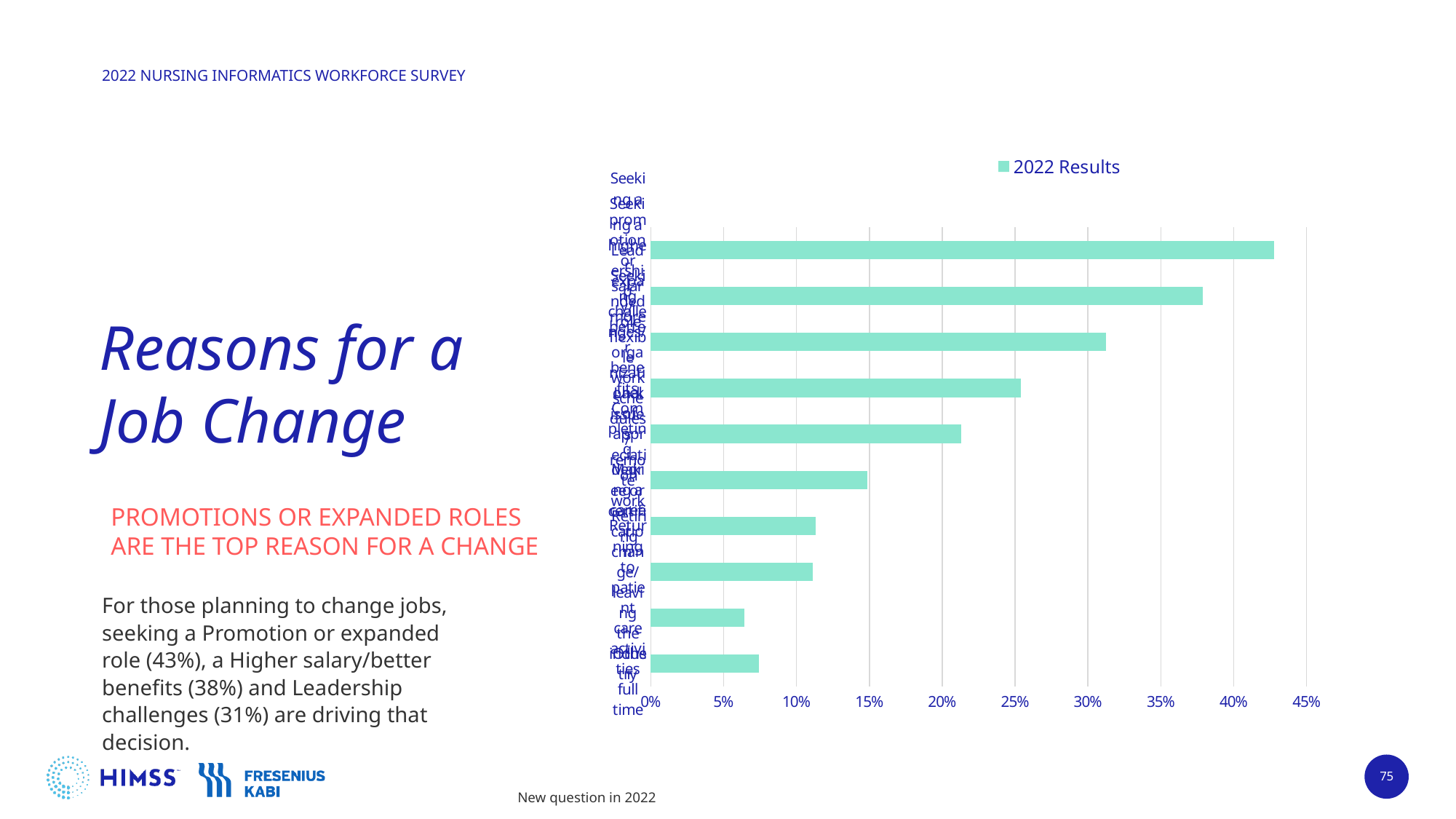
Is the value of the top bar in the chart greater or less than 40%? greater What kind of chart is shown on the slide? bar chart Which bar is the longest in the chart: the top bar or the bottom bar? the top bar Is the value of the third bar from the top greater or less than 30%? greater How many bars are plotted in the chart? 10 Is the value of the second bar from the top greater or less than 35%? greater What is the highest value shown on the chart's horizontal axis? 45% How many series does the chart legend list? 1 What is the series name shown in the chart legend? 2022 Results